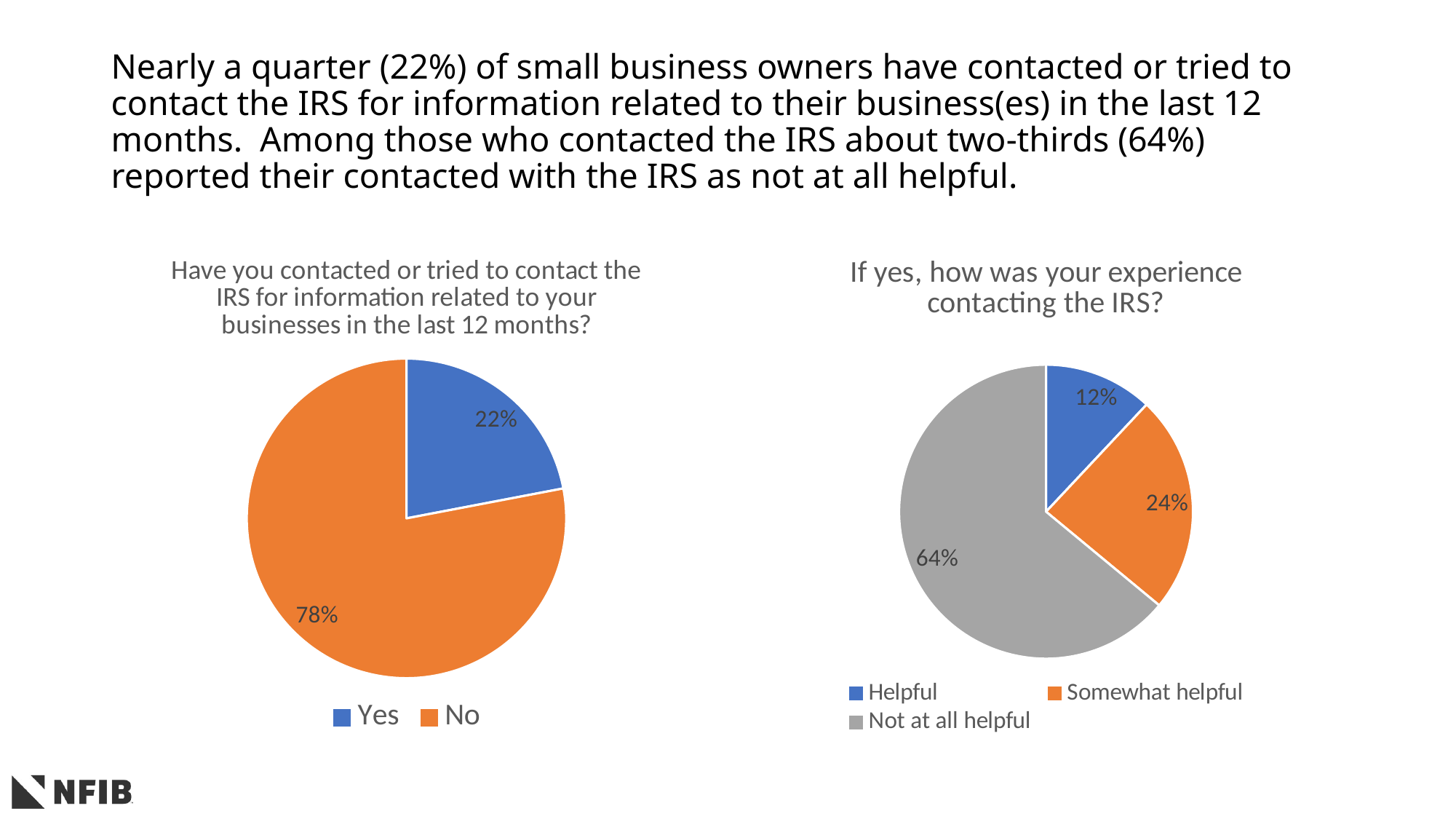
In the left pie chart (Have you contacted or tried to contact the IRS...), what share of respondents answered Yes? 22% In the left pie chart (Have you contacted or tried to contact the IRS...), what share of respondents answered No? 78% In the left pie chart (Have you contacted or tried to contact the IRS...), what is the difference between the No share and the Yes share? 56 percentage points What type of chart is the left chart (Have you contacted or tried to contact the IRS...)? Pie chart How many categories does the legend of the right pie chart (If yes, how was your experience contacting the IRS?) list? 3 In the right pie chart (If yes, how was your experience contacting the IRS?), what share said Somewhat helpful? 24% In the right pie chart (If yes, how was your experience contacting the IRS?), which response has the smallest share? Helpful In the right pie chart (If yes, how was your experience contacting the IRS?), which response has the largest share? Not at all helpful In the right pie chart (If yes, how was your experience contacting the IRS?), what share said Not at all helpful? 64% In the right pie chart (If yes, how was your experience contacting the IRS?), what is the difference between the Not at all helpful share and the Somewhat helpful share? 40 percentage points In the right pie chart (If yes, how was your experience contacting the IRS?), which is larger: Somewhat helpful or Helpful? Somewhat helpful In the right pie chart (If yes, how was your experience contacting the IRS?), what share said Helpful? 12%